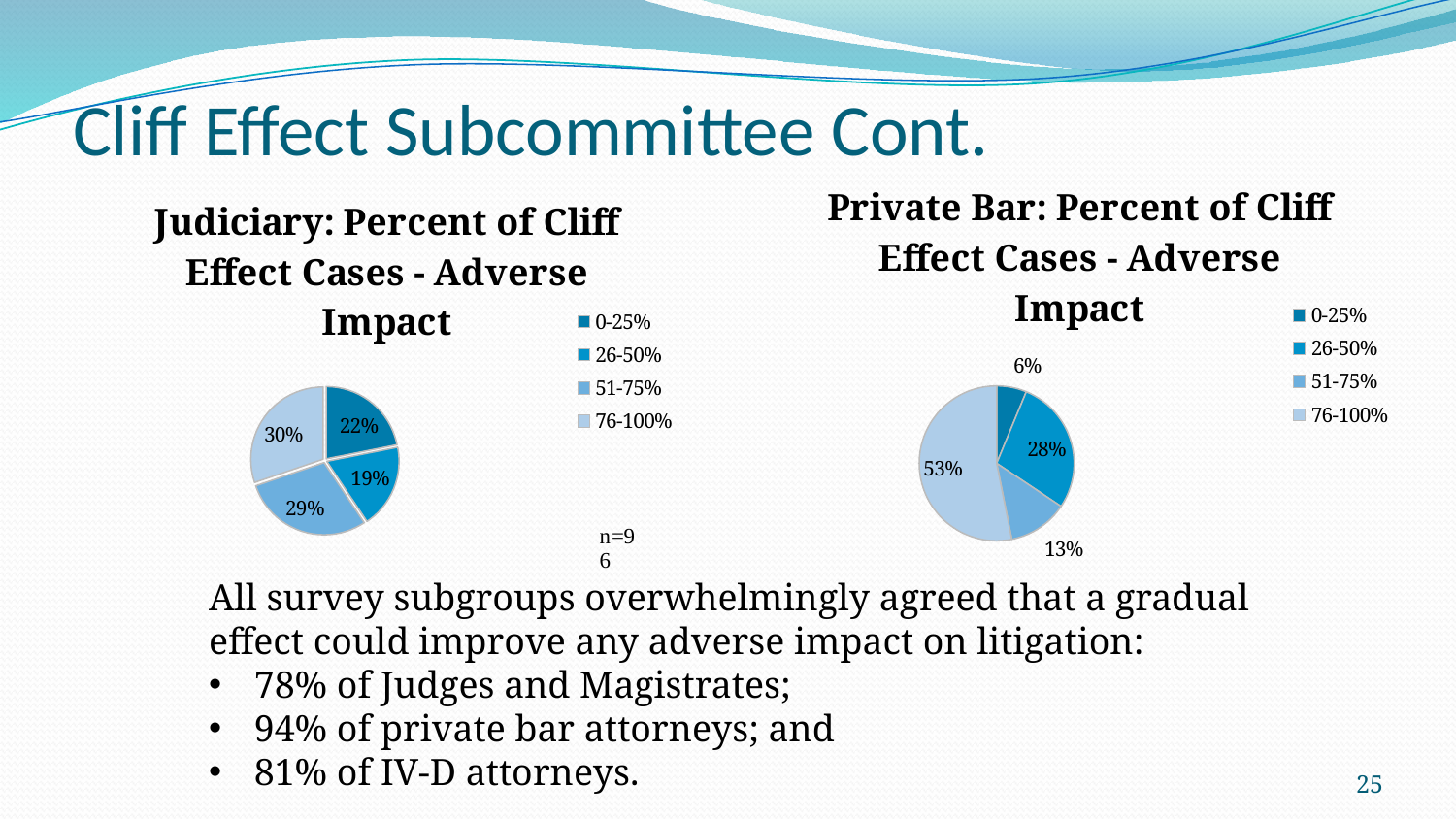
In the Private Bar: Percent of Cliff Effect Cases - Adverse Impact chart, what is the difference between the 76-100% slice and the 26-50% slice? 25% In the Judiciary: Percent of Cliff Effect Cases - Adverse Impact chart, which category has the smallest slice? 26-50% What type of chart is used for the Judiciary: Percent of Cliff Effect Cases - Adverse Impact chart? Pie chart In the Private Bar: Percent of Cliff Effect Cases - Adverse Impact chart, which category has the largest slice? 76-100% In the Private Bar: Percent of Cliff Effect Cases - Adverse Impact chart, what percentage is shown for the 51-75% category? 13% In the Judiciary: Percent of Cliff Effect Cases - Adverse Impact chart, what percentage is shown for the 0-25% category? 22% In the Private Bar: Percent of Cliff Effect Cases - Adverse Impact chart, which category has the smallest slice? 0-25% In the Private Bar: Percent of Cliff Effect Cases - Adverse Impact chart, what percentage is shown for the 26-50% category? 28% In the Judiciary: Percent of Cliff Effect Cases - Adverse Impact chart, which is larger: the 51-75% slice or the 26-50% slice? 51-75% In the Judiciary: Percent of Cliff Effect Cases - Adverse Impact chart, what percentage is shown for the 76-100% category? 30% What sample size is noted beneath the Judiciary: Percent of Cliff Effect Cases - Adverse Impact chart? n=96 How many categories does the legend of the Private Bar: Percent of Cliff Effect Cases - Adverse Impact chart list? 4